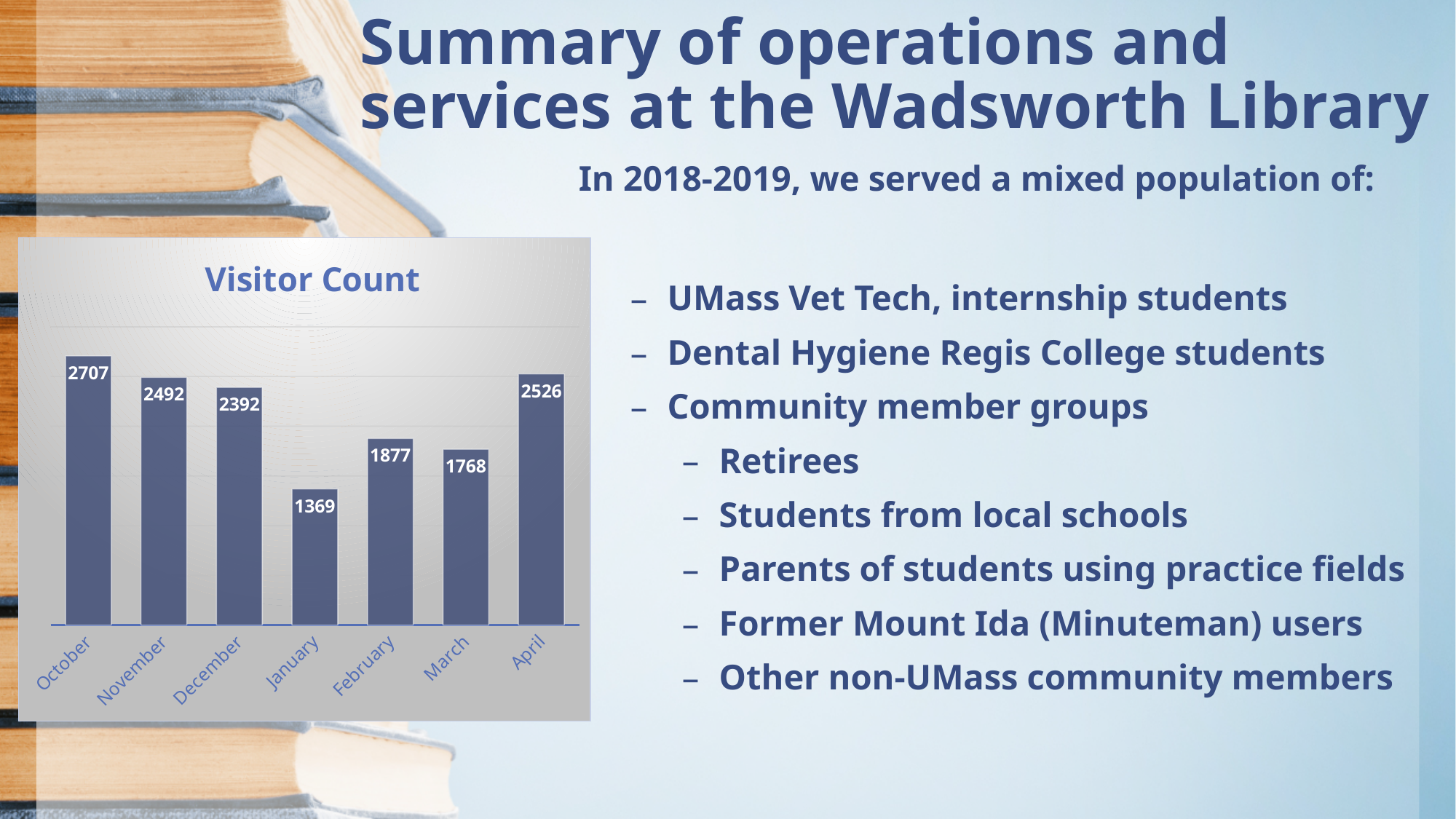
What is the visitor count for October? 2707 What is the difference in visitor count between October and January? 1338 How many months are shown in the Visitor Count chart? 7 What is the visitor count for February? 1877 What is the visitor count for April? 2526 What is the title of the chart on the slide? Visitor Count Which month has the highest visitor count? October Which month has the lowest visitor count? January Which month has a higher visitor count, March or February? February What is the visitor count for January? 1369 What is the difference in visitor count between November and December? 100 What kind of chart is the Visitor Count chart? Bar chart